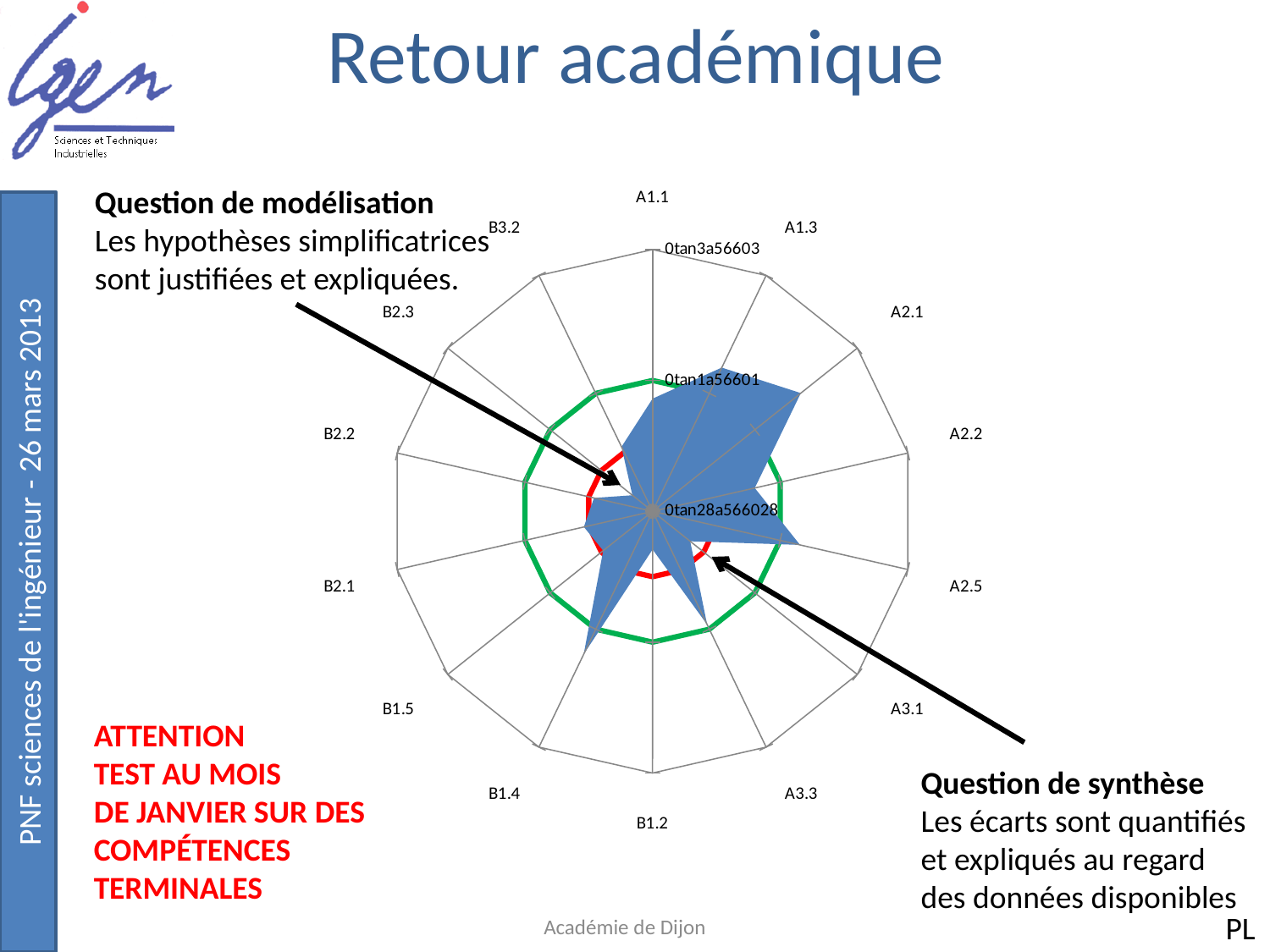
For the blue filled series, is the value for A2.1 larger or smaller than the value for B2.2? larger What colour is the filled area series on the radar chart? blue How many category axes does the radar chart have? 14 For the blue filled series, is the value for A2.1 larger or smaller than the value for A1.1? larger Which category label sits at the top of the radar chart? A1.1 Which category label sits at the bottom of the radar chart? B1.2 What kind of chart is shown on the slide? radar chart